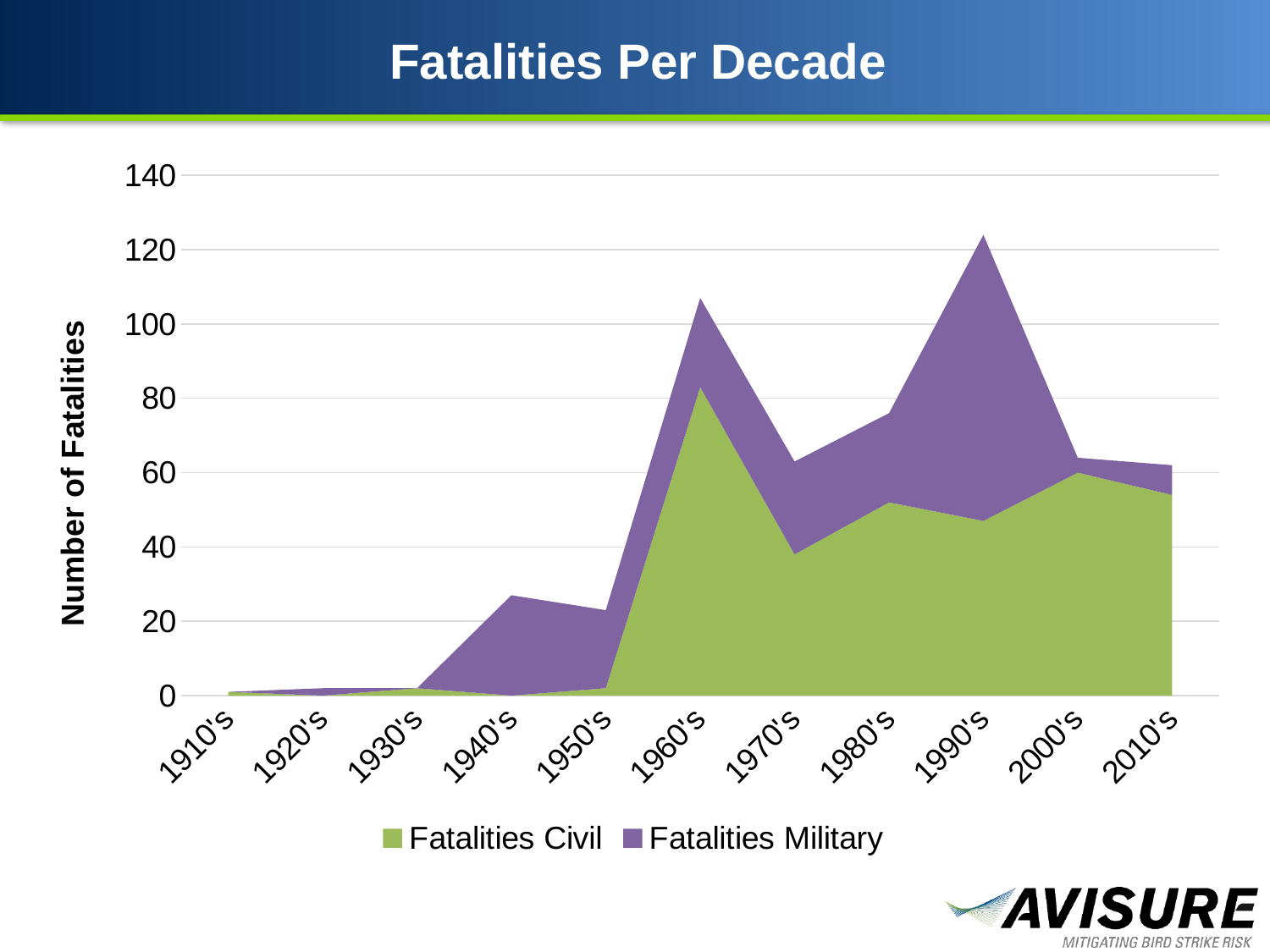
In which decade is the value for Fatalities Civil highest? 1960's How many series does the legend list? 2 Is the value for Fatalities Civil in the 1940's greater or less than 20? less Which is larger: the combined total of fatalities in the 1960's or in the 1970's? 1960's Is the combined total of civil and military fatalities in the 1940's greater or less than 20? greater How many decades are shown along the x axis? 11 In which decade is the combined total of civil and military fatalities highest? 1990's Is the combined total of civil and military fatalities in the 1990's greater or less than 100? greater What kind of chart is shown on the slide? Stacked area chart Does the value for Fatalities Civil rise or fall from the 1970's to the 2000's? rise What is the title of the vertical axis? Number of Fatalities